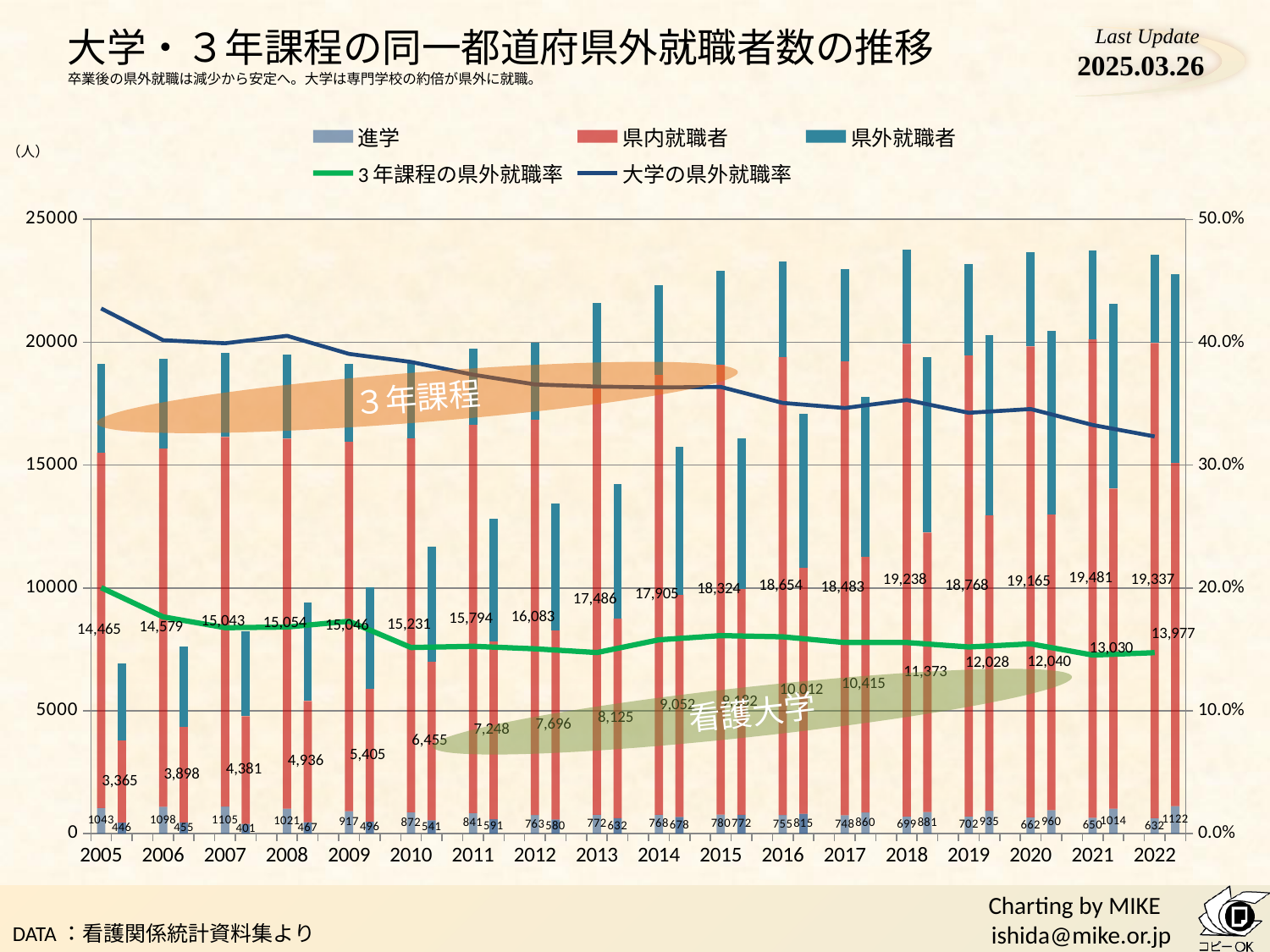
In 2010, which has the larger labelled 県内就職者 value: ３年課程 or 看護大学? ３年課程 What is the 県内就職者 value labelled on the ３年課程 bar for 2005? 14,465 In which year is the labelled 県内就職者 value for ３年課程 the highest? 2021 What is the 進学 value labelled on the ３年課程 bar for 2005? 1043 What is the difference between the 2022 県内就職者 labels for ３年課程 (19,337) and 看護大学 (13,977)? 5,360 What kind of chart is shown on the slide? A bar chart combined with line series What is the 県内就職者 value labelled on the 看護大学 bar for 2022? 13,977 How many years are shown on the x axis? 18 Is the 大学の県外就職率 line value for 2005 greater or less than 40.0%? greater How many series does the legend list? 5 In which year is the labelled 県内就職者 value for 看護大学 the lowest? 2005 Do the labelled 県内就職者 values for 看護大学 rise or fall from 2005 to 2022? Rise